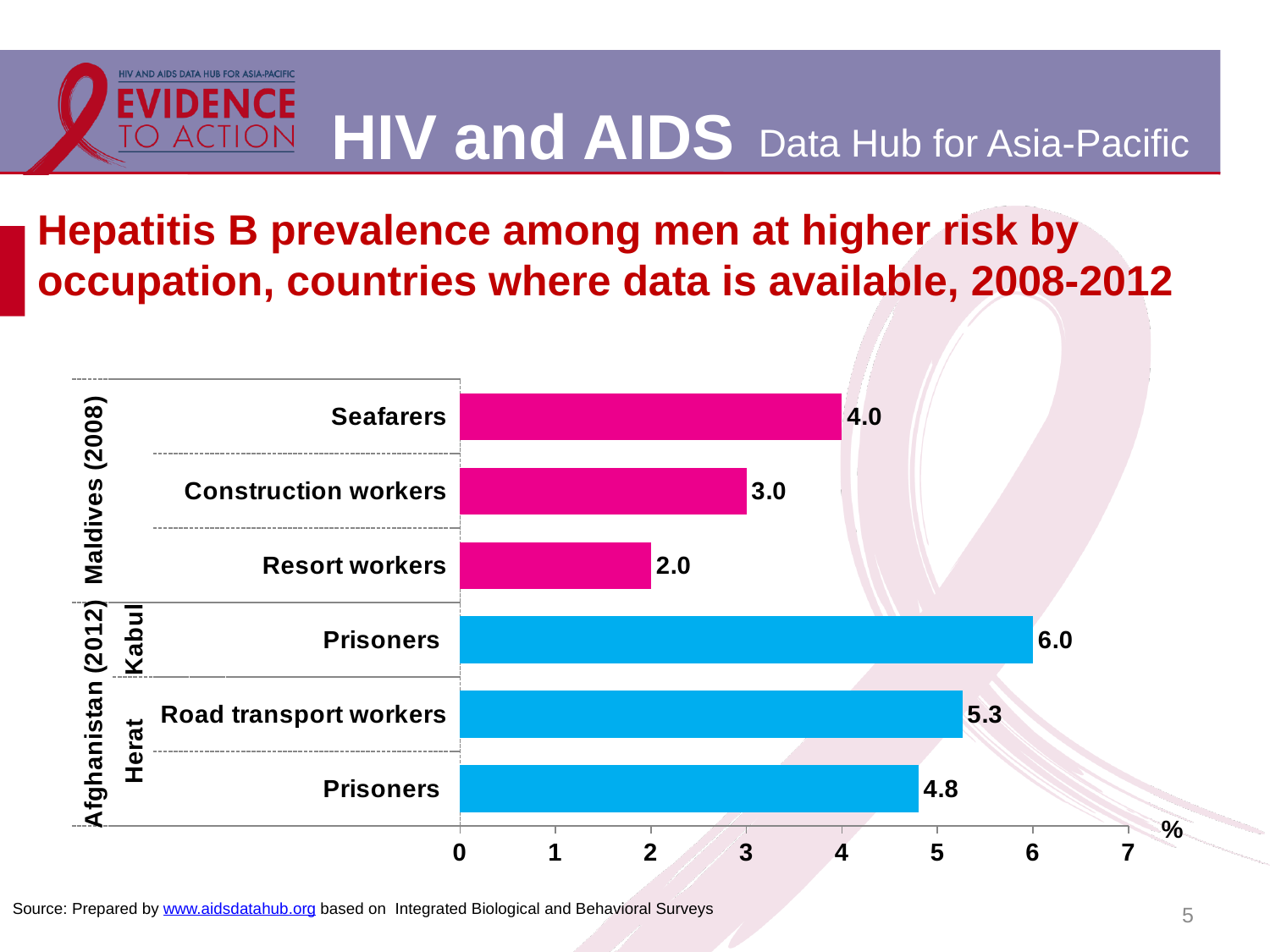
What unit is shown on the x axis of the chart? % What is the difference in hepatitis B prevalence between prisoners in Kabul and prisoners in Herat? 1.2 What type of chart is shown on the slide? Bar chart What is the difference in hepatitis B prevalence between seafarers and construction workers in the Maldives? 1.0 What is the hepatitis B prevalence among resort workers in the Maldives (2008)? 2.0 What is the hepatitis B prevalence among road transport workers in Herat, Afghanistan (2012)? 5.3 Which has a higher hepatitis B prevalence: road transport workers in Herat or seafarers in the Maldives? Road transport workers in Herat What is the hepatitis B prevalence among prisoners in Kabul, Afghanistan (2012)? 6.0 Which group has the lowest hepatitis B prevalence on the chart? Resort workers (Maldives 2008) What is the hepatitis B prevalence among seafarers in the Maldives (2008)? 4.0 Which group has the highest hepatitis B prevalence on the chart? Prisoners (Kabul, Afghanistan 2012) How many occupation groups are plotted on the chart? 6